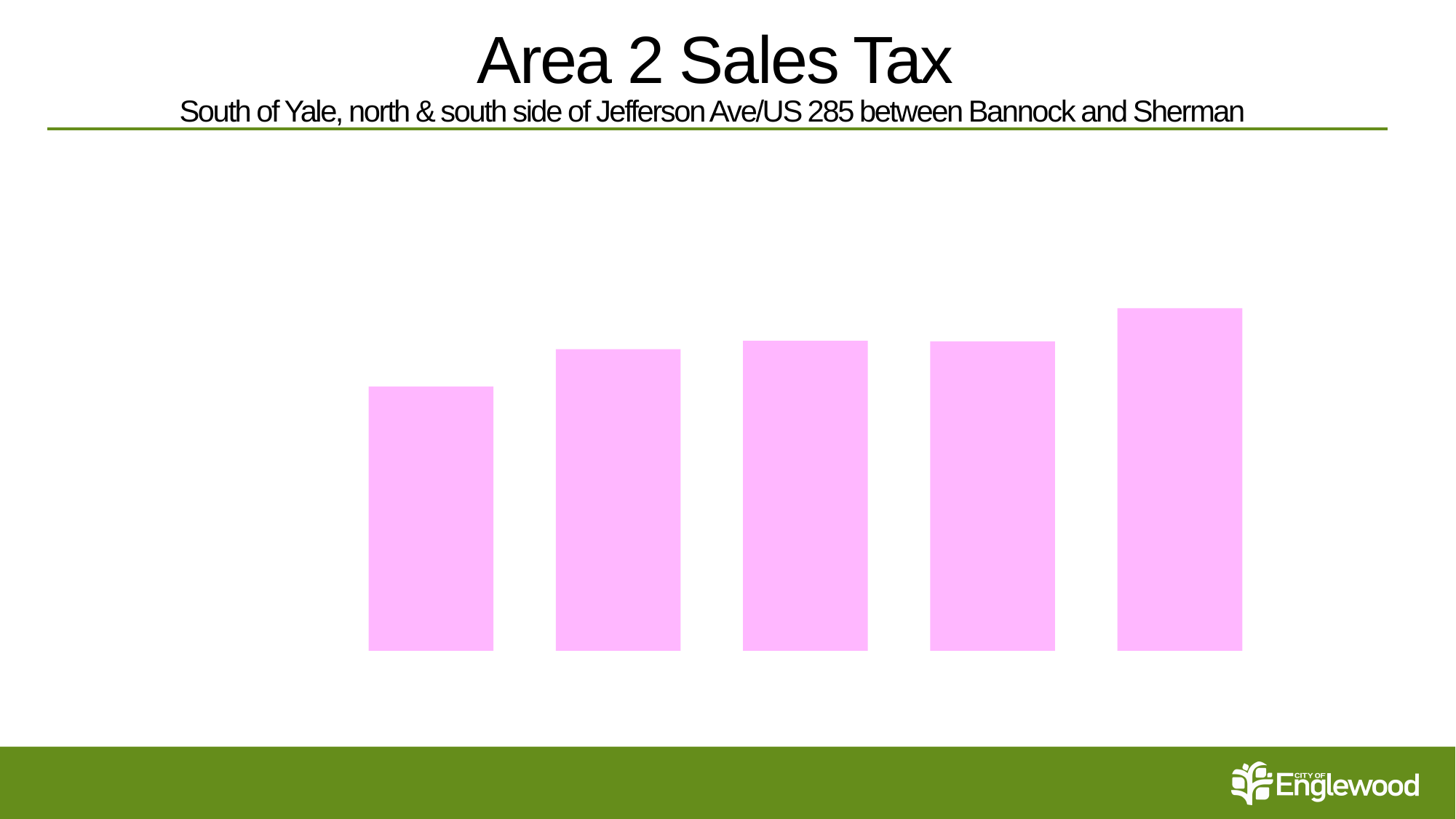
Which is taller, the fourth bar from the left or the fifth bar from the left? the fifth bar from the left What colour are the bars in the chart? pink Which is taller, the first bar from the left or the fifth bar from the left? the fifth bar from the left Do the bar heights generally rise or fall from left to right? rise Which is taller, the first bar from the left or the second bar from the left? the second bar from the left What is the title of the slide containing the chart? Area 2 Sales Tax Which bar is the tallest: the leftmost, the middle, or the rightmost? the rightmost What kind of chart is shown on the slide? bar chart Which bar is the shortest: the leftmost, the middle, or the rightmost? the leftmost How many bars are plotted in the chart? 5